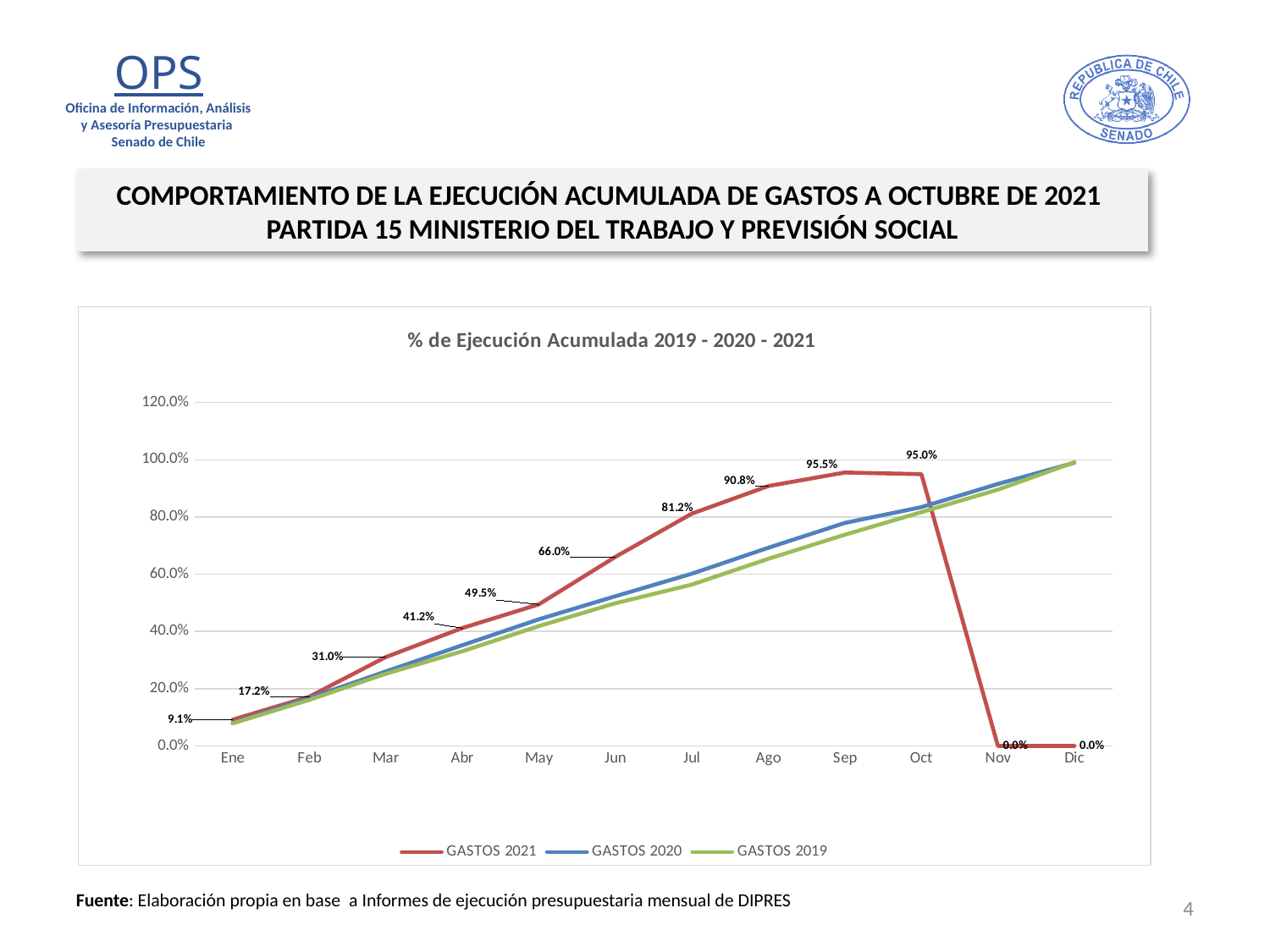
Which is larger for GASTOS 2021: the value in Abr or the value in May? May What is the difference between the GASTOS 2021 values for Sep and Oct? 0.5 percentage points What type of chart is shown? Line chart What is the value for GASTOS 2021 in Jun? 66.0% Is the value for GASTOS 2020 in Dic greater or less than 80.0%? greater In which month does GASTOS 2021 reach its highest value? Sep What is the value for GASTOS 2021 in Ene? 9.1% What is the difference between the GASTOS 2021 values for Jul and Jun? 15.2 percentage points How many months are shown on the x axis? 12 Is the value for GASTOS 2019 in Mar greater or less than 40.0%? less What is the value for GASTOS 2021 in Oct? 95.0% How many series does the legend list? 3